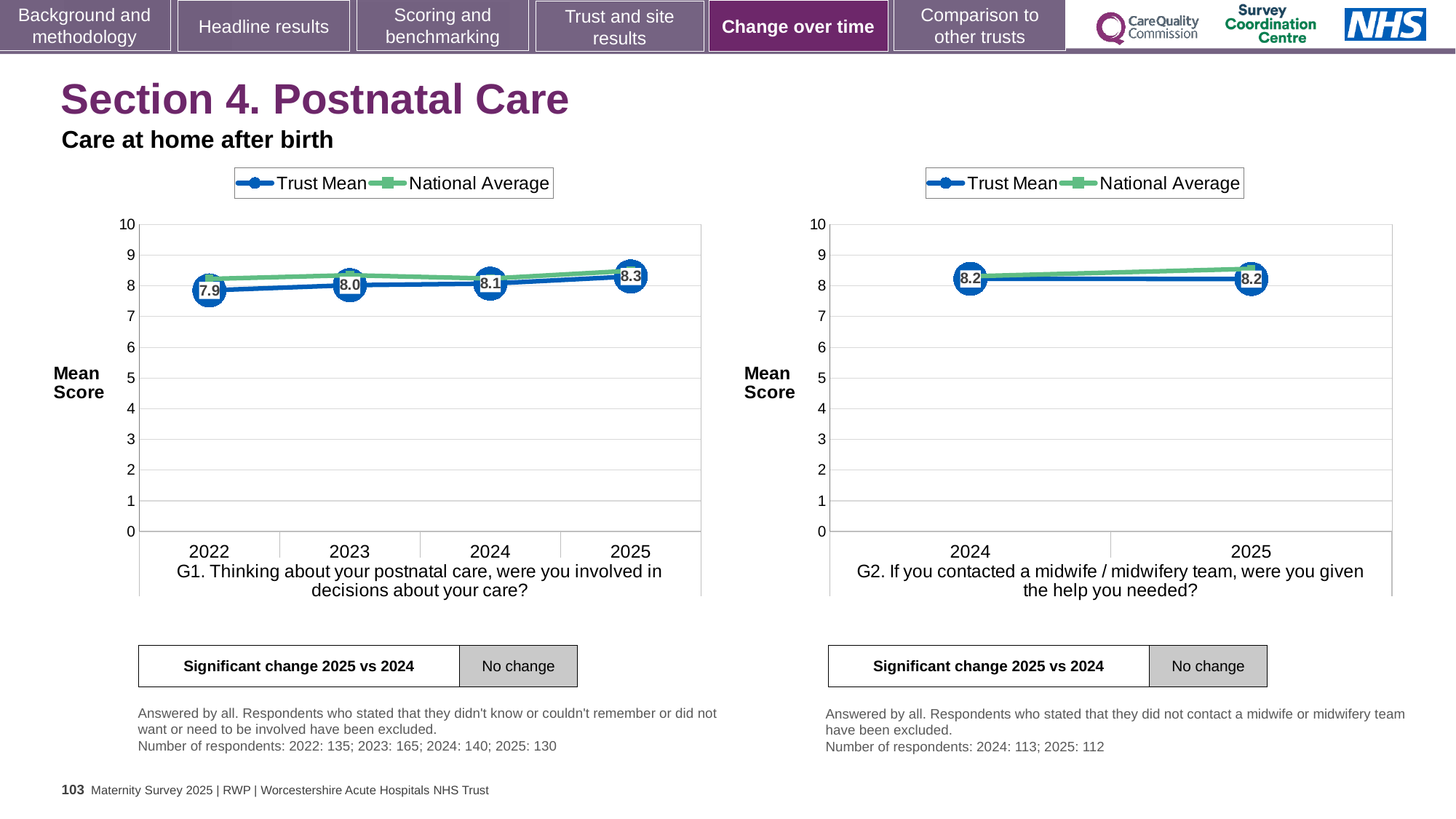
In the G1 chart (left), what is the difference between the Trust Mean for 2025 and the Trust Mean for 2022? 0.4 What kind of chart is the G1 chart (left)? line chart In the G2 chart (right), is the Trust Mean for 2025 greater or less than 5? greater In the G1 chart (left), how many years are plotted on the x axis? 4 In the G1 chart (left), which year has the lowest Trust Mean? 2022 In the G2 chart (right), what is the Trust Mean for 2024? 8.2 In the G1 chart (left), does the Trust Mean rise or fall from 2022 to 2025? rise In the G1 chart (left), which year has the highest Trust Mean? 2025 In the G1 chart (left), what is the Trust Mean for 2022? 7.9 In the G2 chart (right), what is the Trust Mean for 2025? 8.2 In the G1 chart (left), what is the Trust Mean for 2025? 8.3 How many series does the legend of the G2 chart (right) list? 2